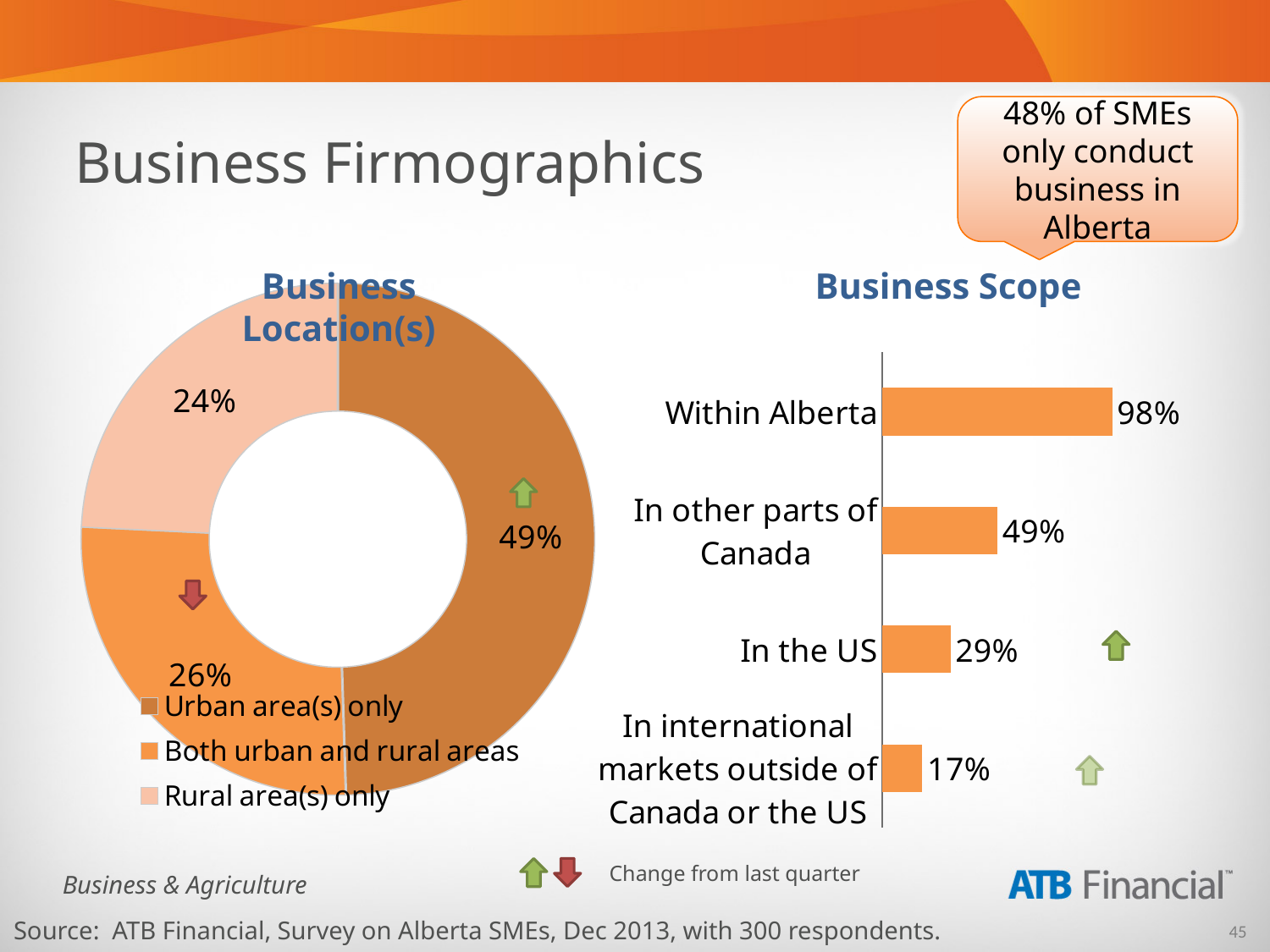
In the Business Scope chart, what percentage of SMEs conduct business within Alberta? 98% In the Business Scope chart, what percentage of SMEs conduct business in international markets outside of Canada or the US? 17% In the Business Location(s) chart, what is the difference between the share for urban area(s) only and the share for both urban and rural areas? 23 percentage points In the Business Scope chart, what is the difference between the value for In other parts of Canada and the value for In the US? 20 percentage points In the Business Location(s) chart, how many categories does the legend list? 3 In the Business Location(s) chart, what share of SMEs operate in rural area(s) only? 24% In the Business Scope chart, which category has the highest value? Within Alberta What kind of chart is the Business Scope chart? Bar chart What kind of chart is the Business Location(s) chart? Donut (pie) chart In the Business Location(s) chart, which category has the smallest share? Rural area(s) only In the Business Scope chart, which is larger: the value for In the US or the value for In international markets outside of Canada or the US? In the US In the Business Location(s) chart, what share of SMEs operate in urban area(s) only? 49%